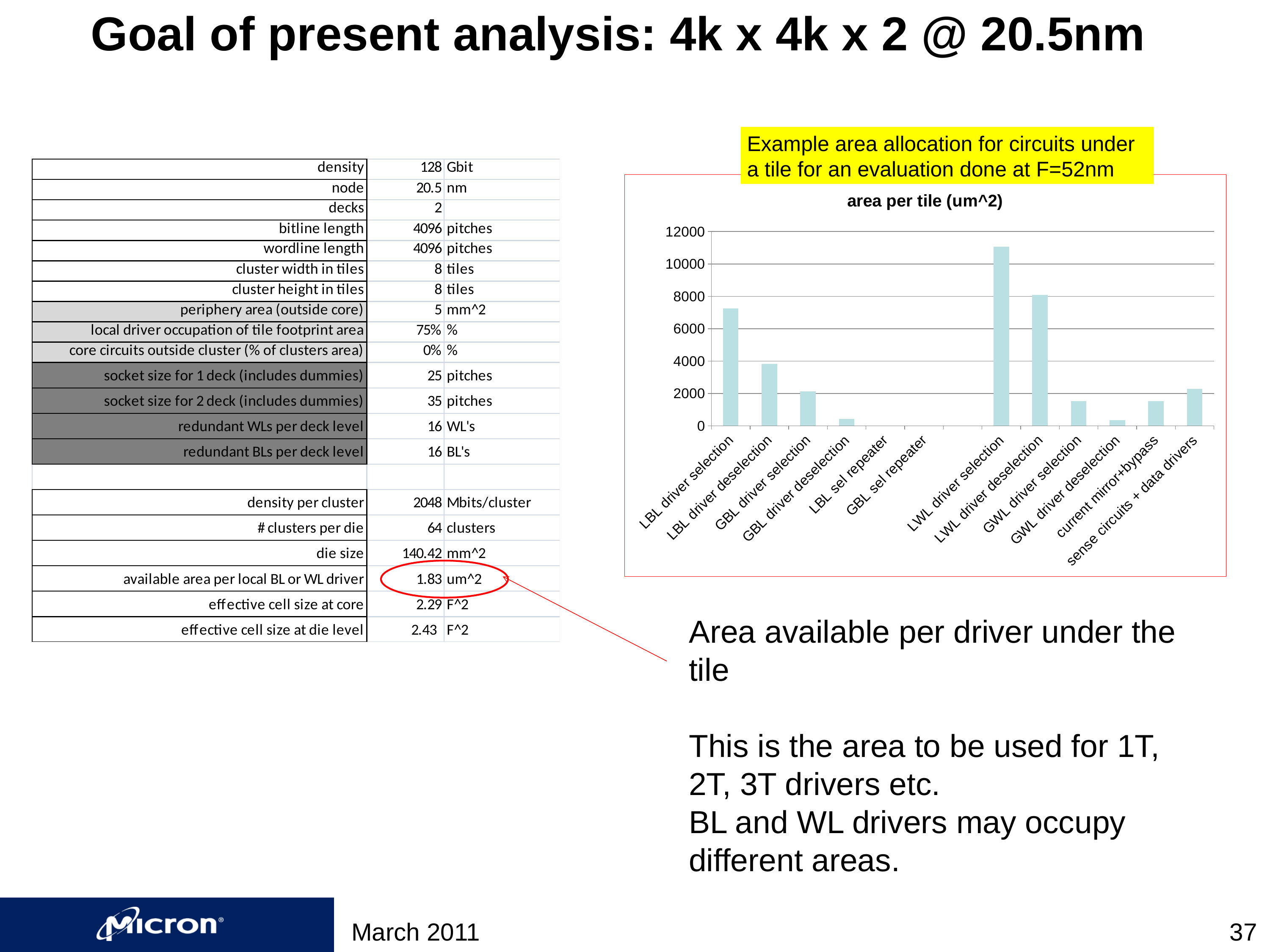
Is the value for LBL driver selection greater or less than 6000? greater Which category has the highest area per tile? LWL driver selection Which is larger, the value for LBL driver selection or LBL driver deselection? LBL driver selection What is the title of the chart? area per tile (um^2) How many categories are shown on the x axis of the chart? 12 What kind of chart is shown on the slide? bar chart Is the value for LWL driver deselection greater or less than 6000? greater Is the value for GWL driver selection greater or less than 2000? less Which is larger, the value for LWL driver deselection or LBL driver selection? LWL driver deselection